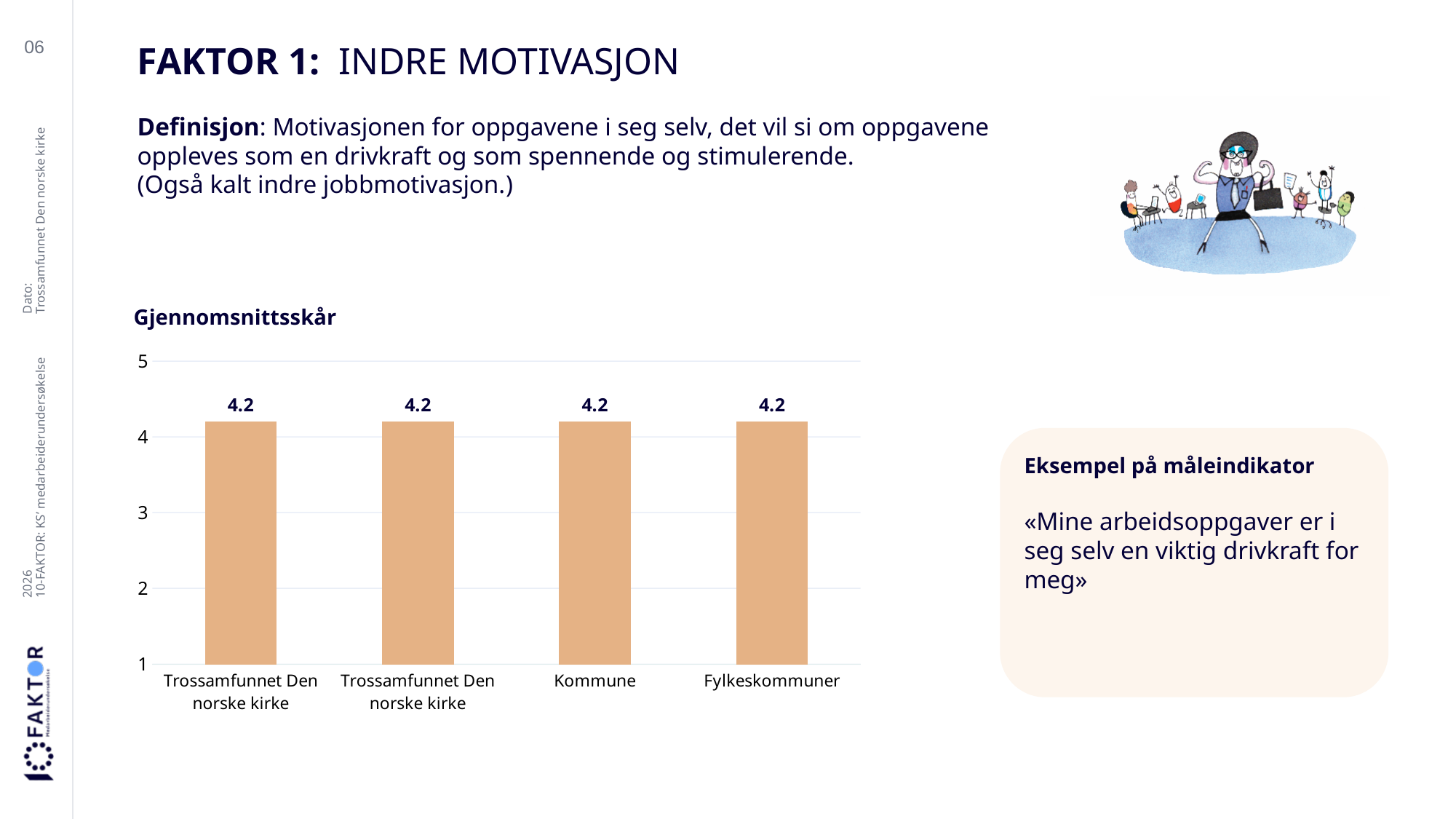
What is the difference between the values for Kommune and Fylkeskommuner? 0 What is the value for Kommune in the Gjennomsnittsskår chart? 4.2 What value is shown for the first Trossamfunnet Den norske kirke bar in the chart? 4.2 Is the value for Kommune greater or less than 3? greater What is the title of the chart on the slide? Gjennomsnittsskår What is the highest value shown on the vertical axis of the chart? 5 Is the value for Fylkeskommuner greater or less than 5? less What is the value for Fylkeskommuner in the Gjennomsnittsskår chart? 4.2 How many bars are plotted in the Gjennomsnittsskår chart? 4 What kind of chart is shown on the slide? Bar chart Do the values rise, fall or stay flat across the categories from left to right? Stay flat